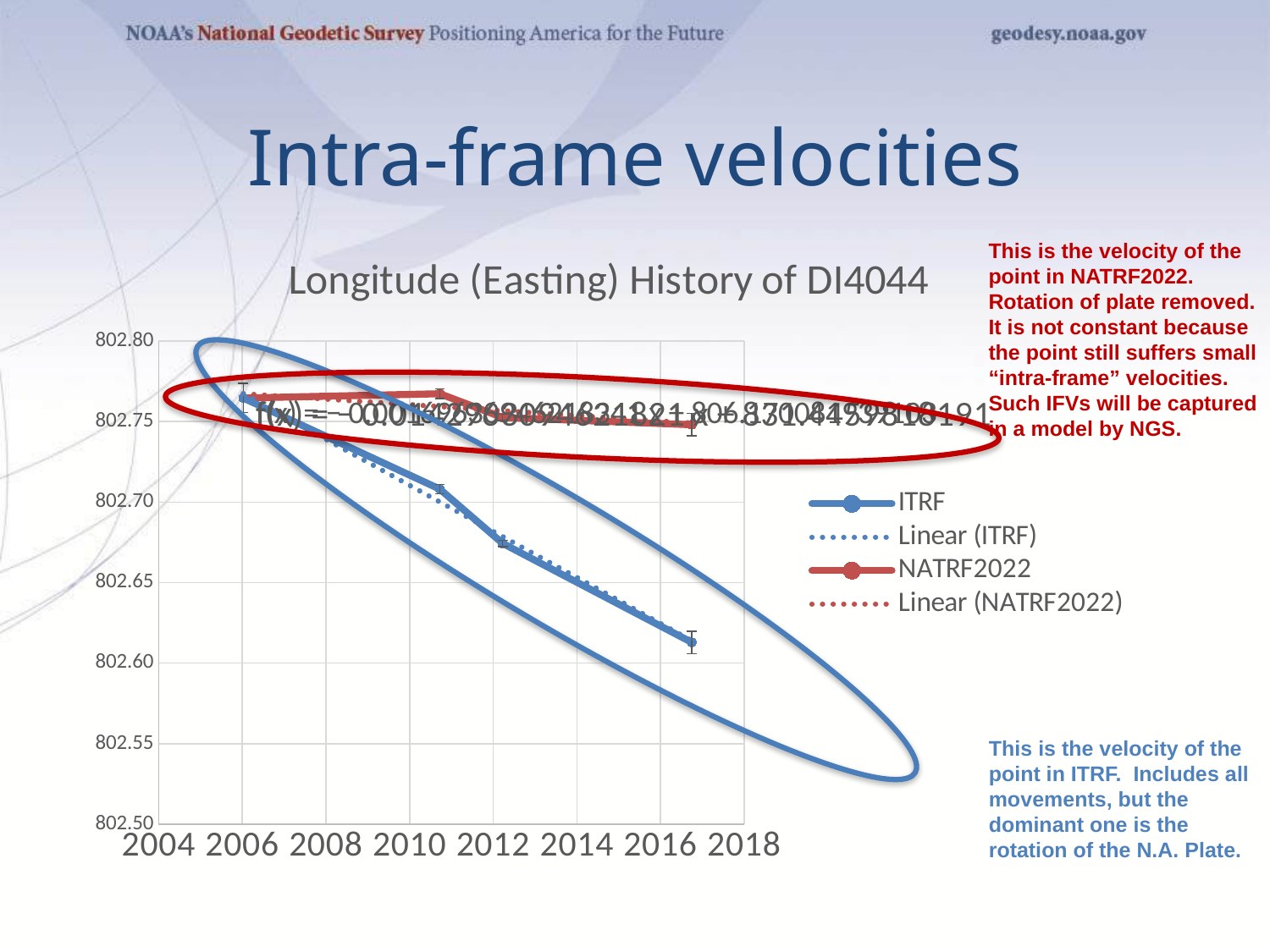
Is the ITRF value at its first point (around 2006) greater or less than 802.75? greater What kind of chart is shown on the slide? line chart At the last plotted point (around 2016), which series has the larger value, ITRF or NATRF2022? NATRF2022 What is the title of the chart? Longitude (Easting) History of DI4044 Is the NATRF2022 value at its point around 2010 greater or less than 802.75? greater How many data points are plotted for the ITRF series? 4 Do the ITRF values rise or fall from 2006 to 2016? fall What is the lowest value shown on the vertical axis? 802.50 Is the ITRF value at its last point (around 2016) greater or less than 802.65? less Which series shows the larger overall decrease over the plotted period, ITRF or NATRF2022? ITRF Which series are listed in the chart legend? ITRF, Linear (ITRF), NATRF2022, Linear (NATRF2022) How many series does the chart legend list? 4